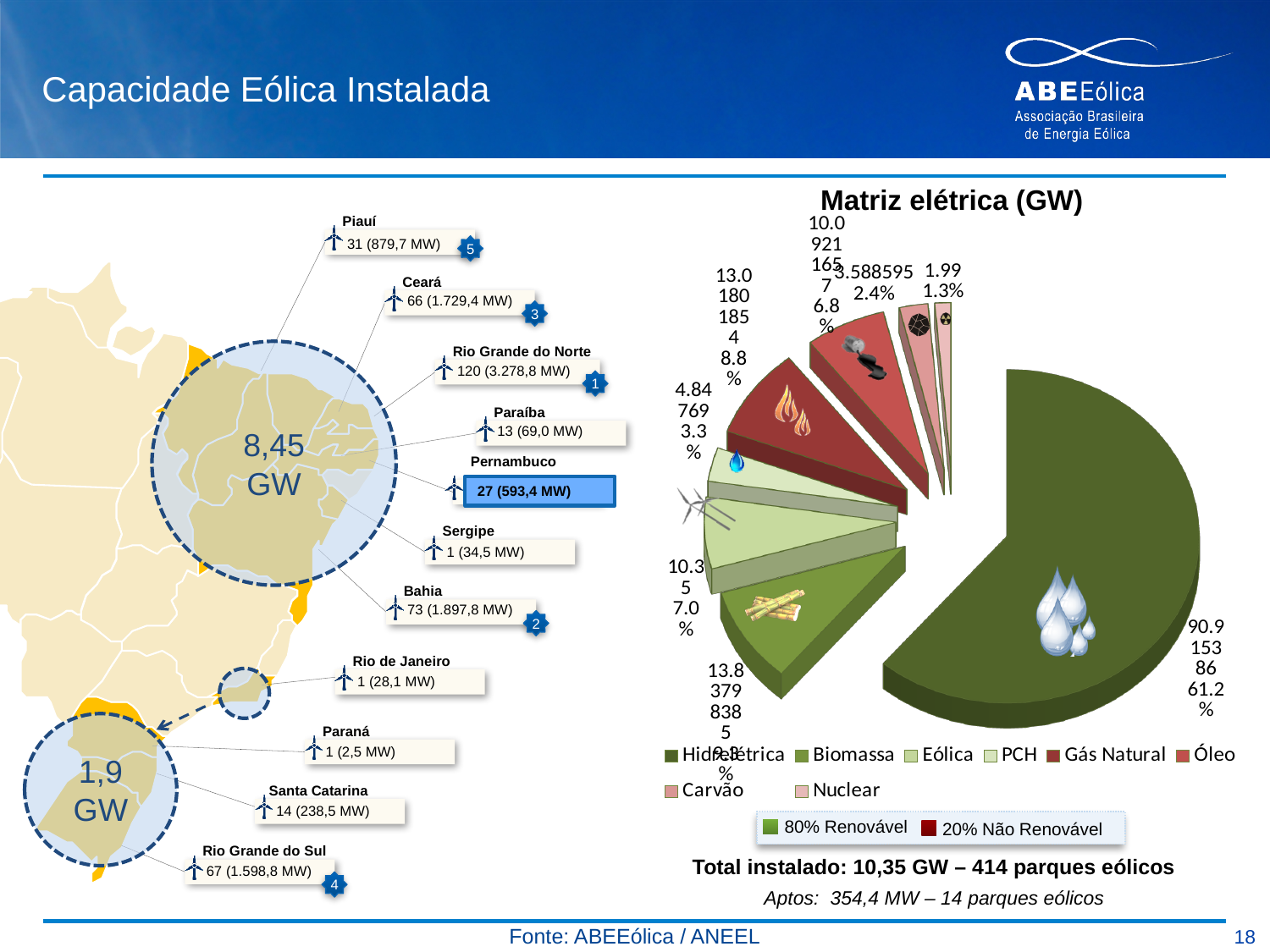
In the 'Matriz elétrica (GW)' pie chart, what percentage share does Nuclear have? 1.3% What is the title of the pie chart on the right of the slide? Matriz elétrica (GW) In the 'Matriz elétrica (GW)' pie chart, what percentage share does Eólica have? 7.0% In the 'Matriz elétrica (GW)' pie chart, which source has the smallest slice? Nuclear How many entries does the legend of the 'Matriz elétrica (GW)' pie chart list? 8 What kind of chart is the 'Matriz elétrica (GW)' chart? pie chart In the 'Matriz elétrica (GW)' pie chart, what percentage share does Gás Natural have? 8.8% In the 'Matriz elétrica (GW)' pie chart, which source has the largest slice? Hidrelétrica In the 'Matriz elétrica (GW)' pie chart, which has the larger share, Gás Natural or Óleo? Gás Natural